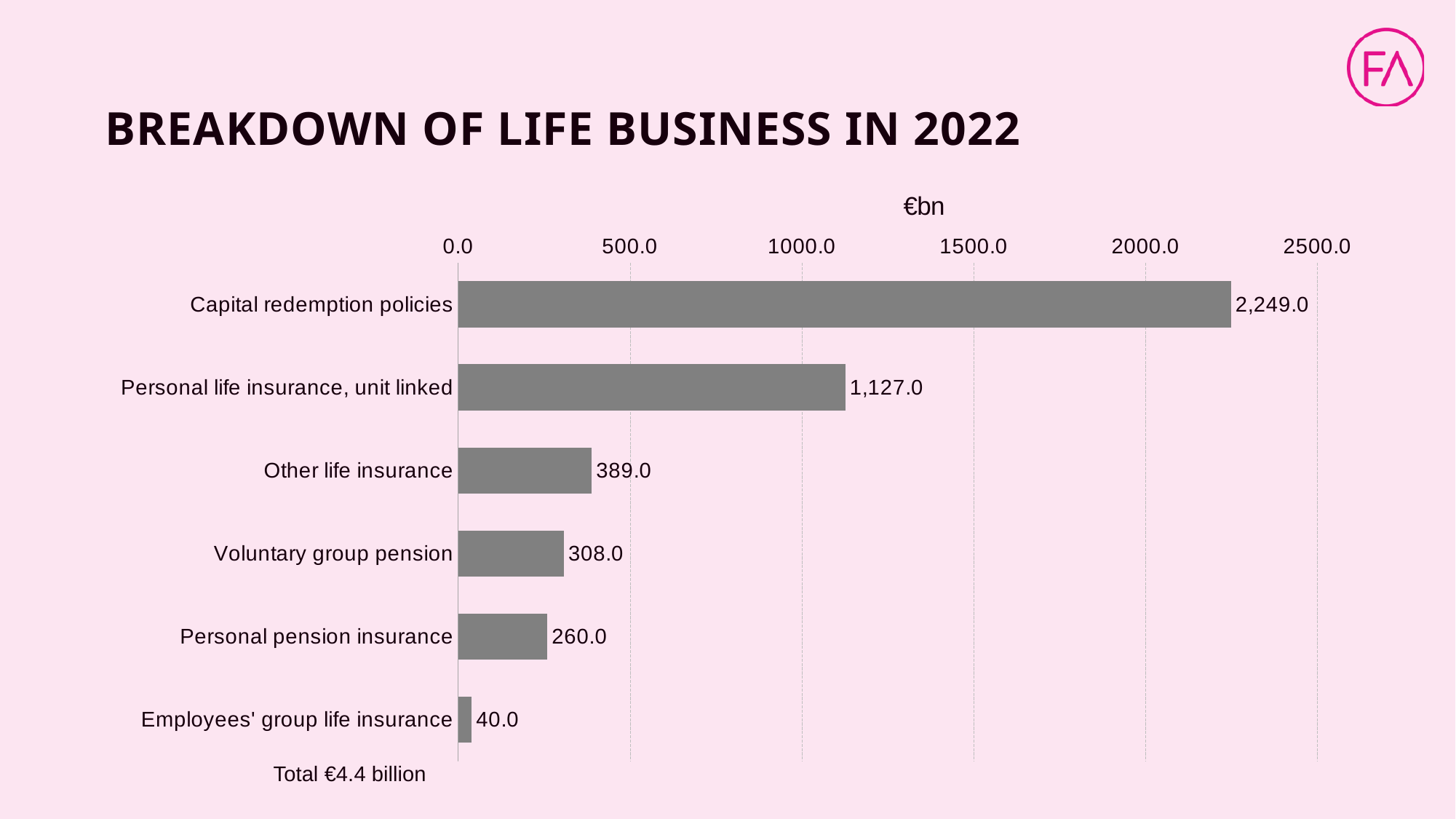
What is the value for Capital redemption policies? 2,249.0 What is the value for Personal life insurance, unit linked? 1,127.0 How many categories are shown in the chart? 6 What is the difference between Capital redemption policies and Personal life insurance, unit linked? 1,122.0 Which category has the highest value? Capital redemption policies What is the title of the chart? BREAKDOWN OF LIFE BUSINESS IN 2022 What kind of chart is shown on the slide? Bar chart What is the value for Other life insurance? 389.0 What is the difference between Voluntary group pension and Personal pension insurance? 48.0 Which is larger, Other life insurance or Voluntary group pension? Other life insurance What is the value for Employees' group life insurance? 40.0 Which category has the lowest value? Employees' group life insurance